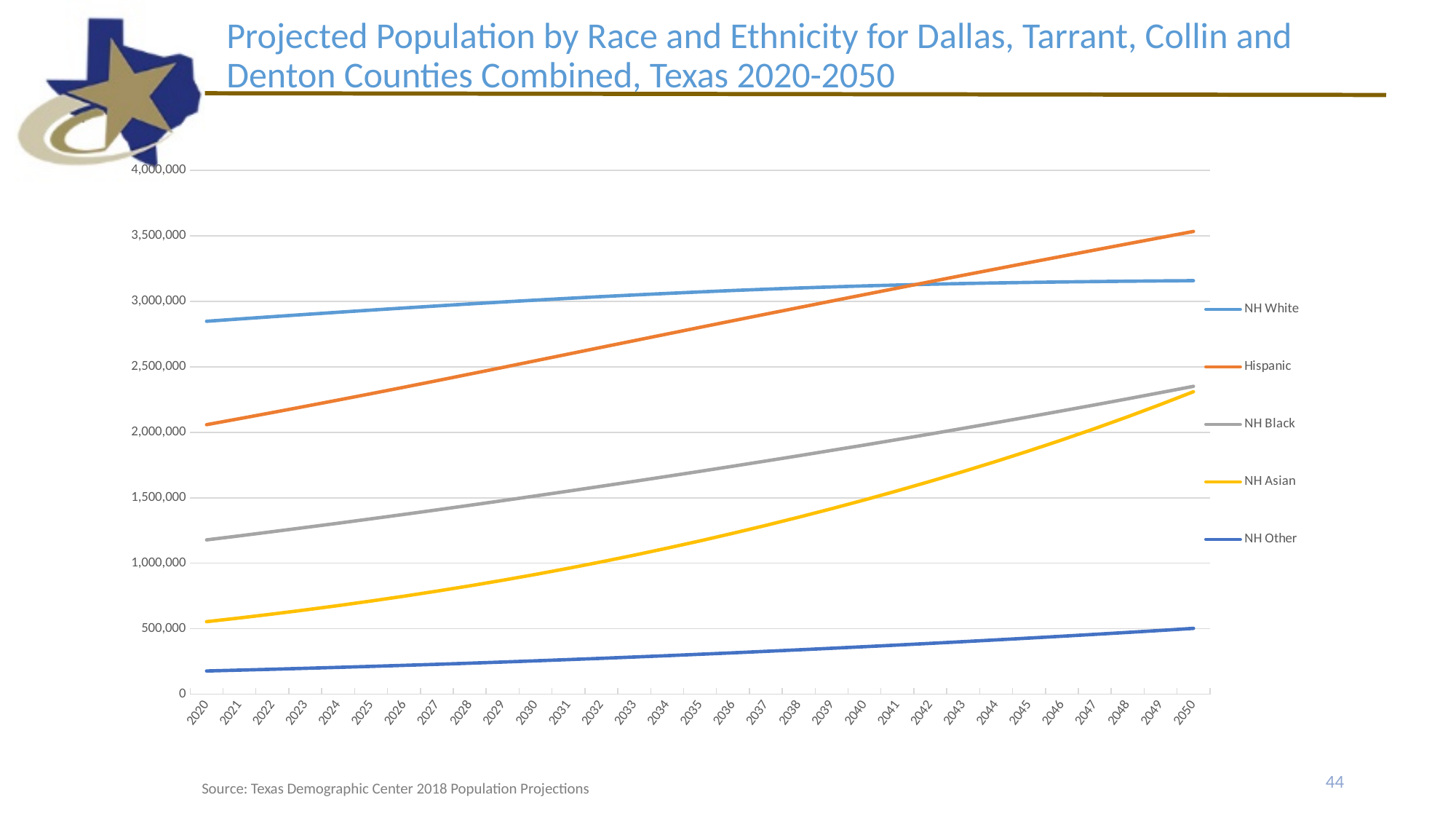
Which series has the highest projected population in 2020? NH White How many years are shown along the x axis? 31 What colour is the Hispanic line? Orange Does the NH Asian line rise or fall from 2020 to 2050? Rises Is the value for NH Black in 2050 greater or less than 2,000,000? greater How many series does the legend list? 5 Is the value for NH Asian in 2020 greater or less than 1,000,000? less Is the value for NH White in 2020 greater or less than 2,500,000? greater Which is larger in 2050, the NH White value or the Hispanic value? Hispanic Which series has the highest projected population in 2050? Hispanic Which series has the lowest projected population in 2050? NH Other What kind of chart is shown on the slide? Line chart